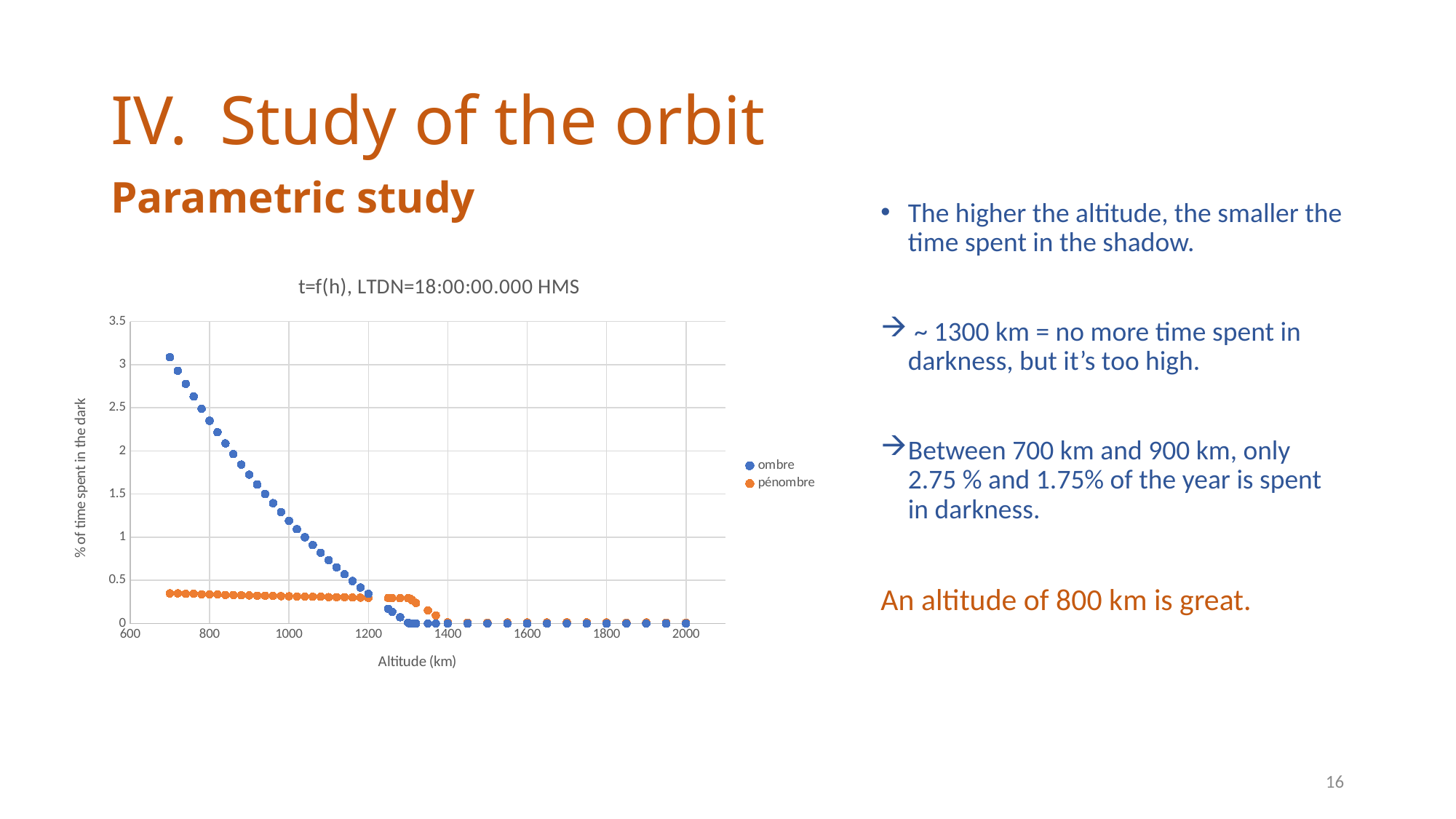
Is the pénombre value at 800 km altitude greater or less than 0.5? less Is the ombre value at 1000 km altitude greater or less than 1? greater What are the two series named in the chart legend? ombre and pénombre What is the title of the chart? t=f(h), LTDN=18:00:00.000 HMS How many series does the chart legend list? 2 Is the ombre value at 800 km altitude greater or less than 2? greater What kind of chart is shown on the slide? scatter plot Does the ombre series rise or fall as altitude increases from 700 km to 1300 km? fall At 800 km altitude, which series has the larger value, ombre or pénombre? ombre